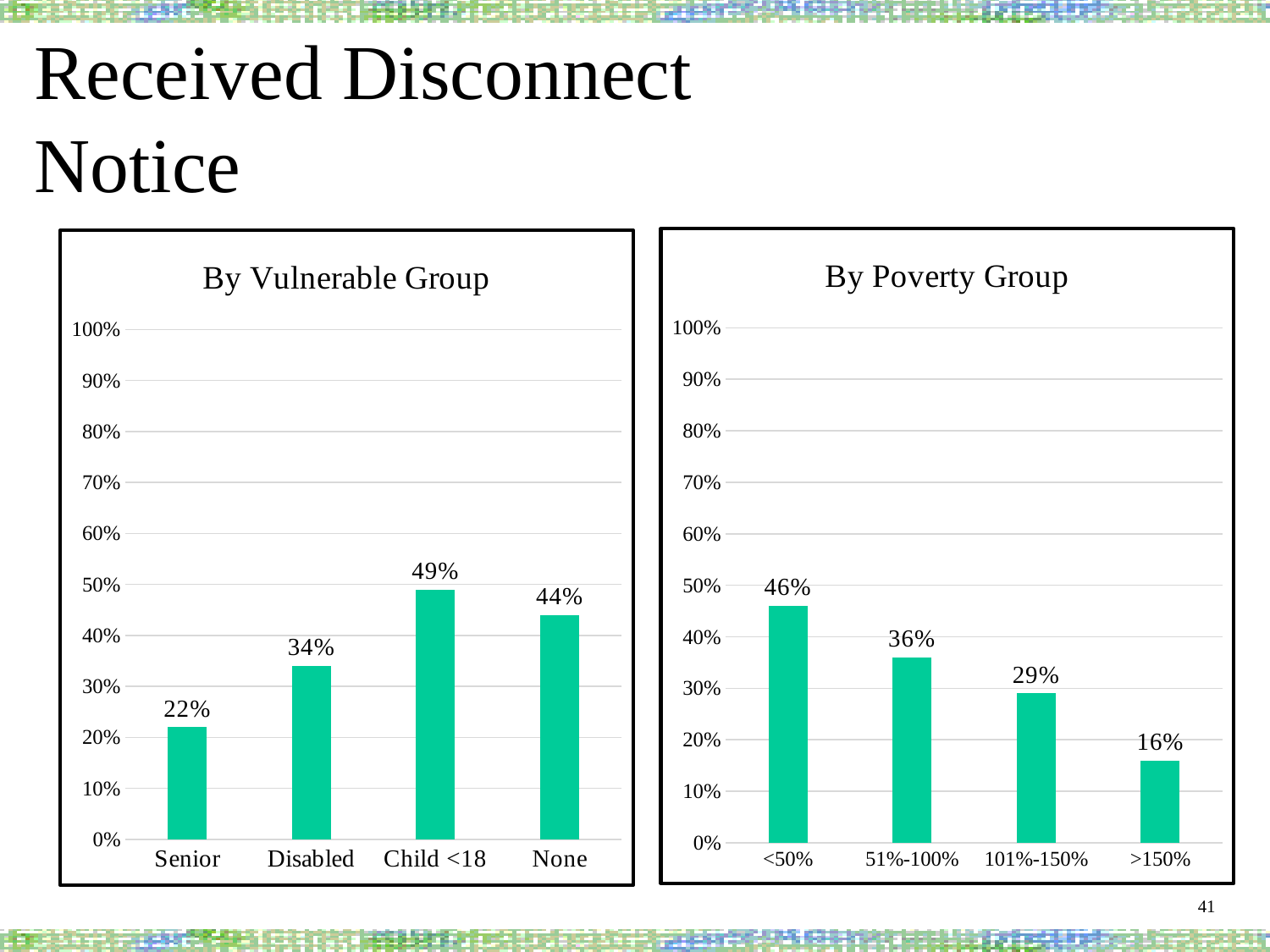
In the 'By Vulnerable Group' chart, how many categories are shown? 4 In the 'By Poverty Group' chart, do the values rise or fall from left to right along the x axis? fall In the 'By Poverty Group' chart, what is the value for >150%? 16% In the 'By Vulnerable Group' chart, what is the value for Senior? 22% In the 'By Vulnerable Group' chart, which category has the lowest value? Senior In the 'By Vulnerable Group' chart, what is the difference between the values for Child <18 and None? 5% In the 'By Poverty Group' chart, what is the difference between the values for <50% and 51%-100%? 10% In the 'By Poverty Group' chart, what is the value for 101%-150%? 29% In the 'By Vulnerable Group' chart, which category has the highest value? Child <18 In the 'By Poverty Group' chart, which category has the highest value? <50% What kind of chart is the 'By Poverty Group' chart? bar chart In the 'By Vulnerable Group' chart, what is the value for Disabled? 34%